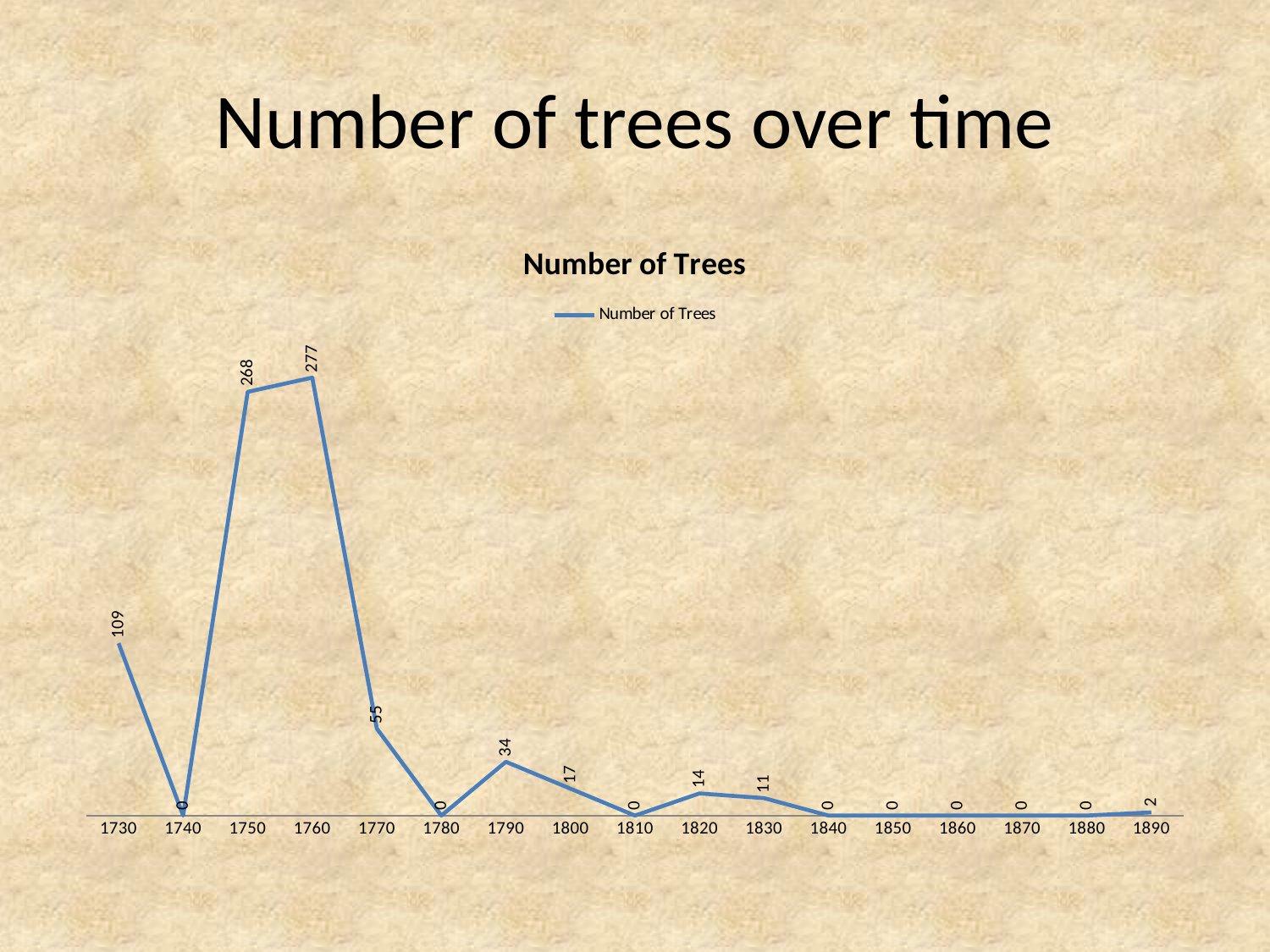
What is the title of the chart? Number of Trees What is the difference in the number of trees between 1770 and 1790? 21 How many series does the legend list? 1 Which year has more trees, 1800 or 1820? 1800 What kind of chart is shown on the slide? Line chart What is the number of trees in 1760? 277 Which year has the highest number of trees? 1760 What is the number of trees in 1730? 109 What is the number of trees in 1890? 2 What is the difference in the number of trees between 1760 and 1750? 9 What is the number of trees in 1790? 34 How many years are plotted on the x axis? 17